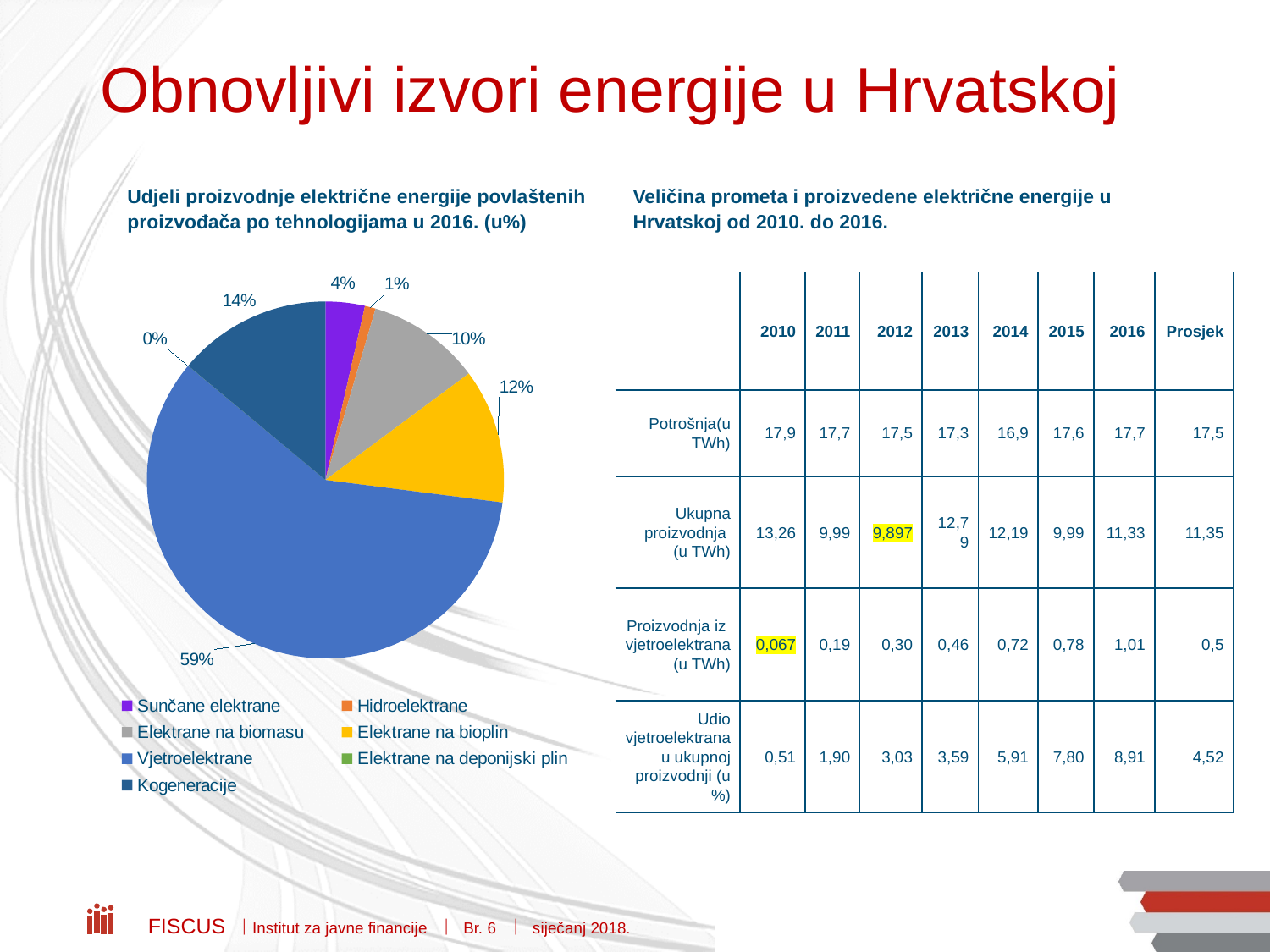
What is the title of the pie chart? Udjeli proizvodnje električne energije povlaštenih proizvođača po tehnologijama u 2016. (u%) How many categories does the legend of the pie chart list? 7 In the pie chart, what share does Kogeneracije have? 14% Which category has the largest slice in the pie chart? Vjetroelektrane In the pie chart, what is the difference in percentage points between Kogeneracije and Elektrane na bioplin? 2 In the pie chart, which is larger: Elektrane na biomasu or Sunčane elektrane? Elektrane na biomasu In the pie chart, what share does Elektrane na bioplin have? 12% In the pie chart, what share does Sunčane elektrane have? 4% What type of chart is shown on the left of the slide? Pie chart In the pie chart, what share does Elektrane na biomasu have? 10% Which category has the smallest slice in the pie chart? Elektrane na deponijski plin In the pie chart, what share does Vjetroelektrane have? 59%